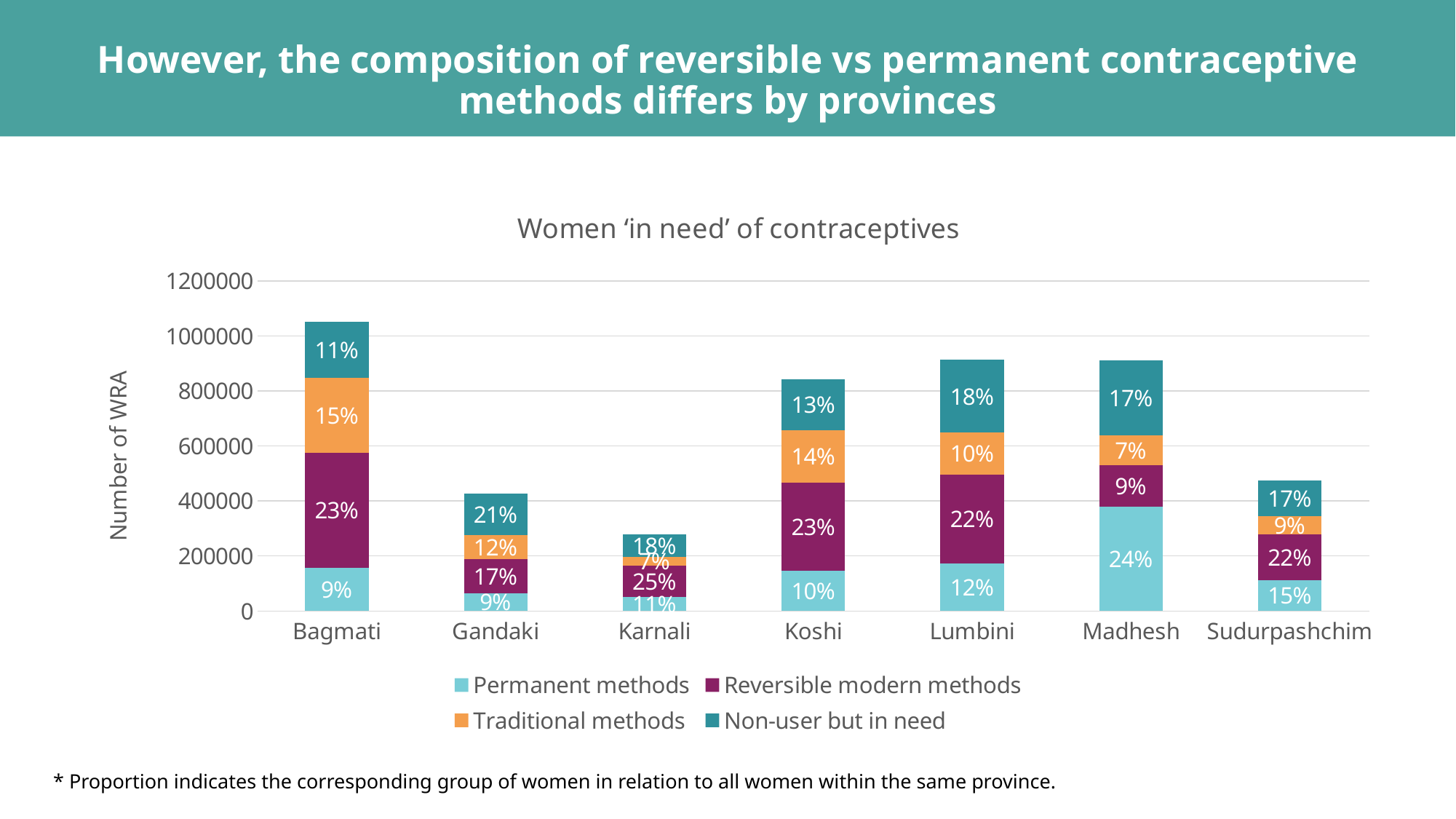
How many series does the legend list? 4 What percentage label is shown for Reversible modern methods in Karnali? 25% What is the title of the y axis? Number of WRA What percentage label is shown for Traditional methods in Koshi? 14% What kind of chart is shown on the slide? Stacked bar chart Which province has the tallest stacked bar? Bagmati What percentage label is shown for Non-user but in need in Gandaki? 21% What percentage label is shown for Permanent methods in Madhesh? 24% Is the total bar height for Sudurpashchim greater or less than 400000? greater How many provinces are shown on the x axis of the chart? 7 Is the total bar height for Bagmati greater or less than 1000000? greater Which province has the shortest stacked bar? Karnali